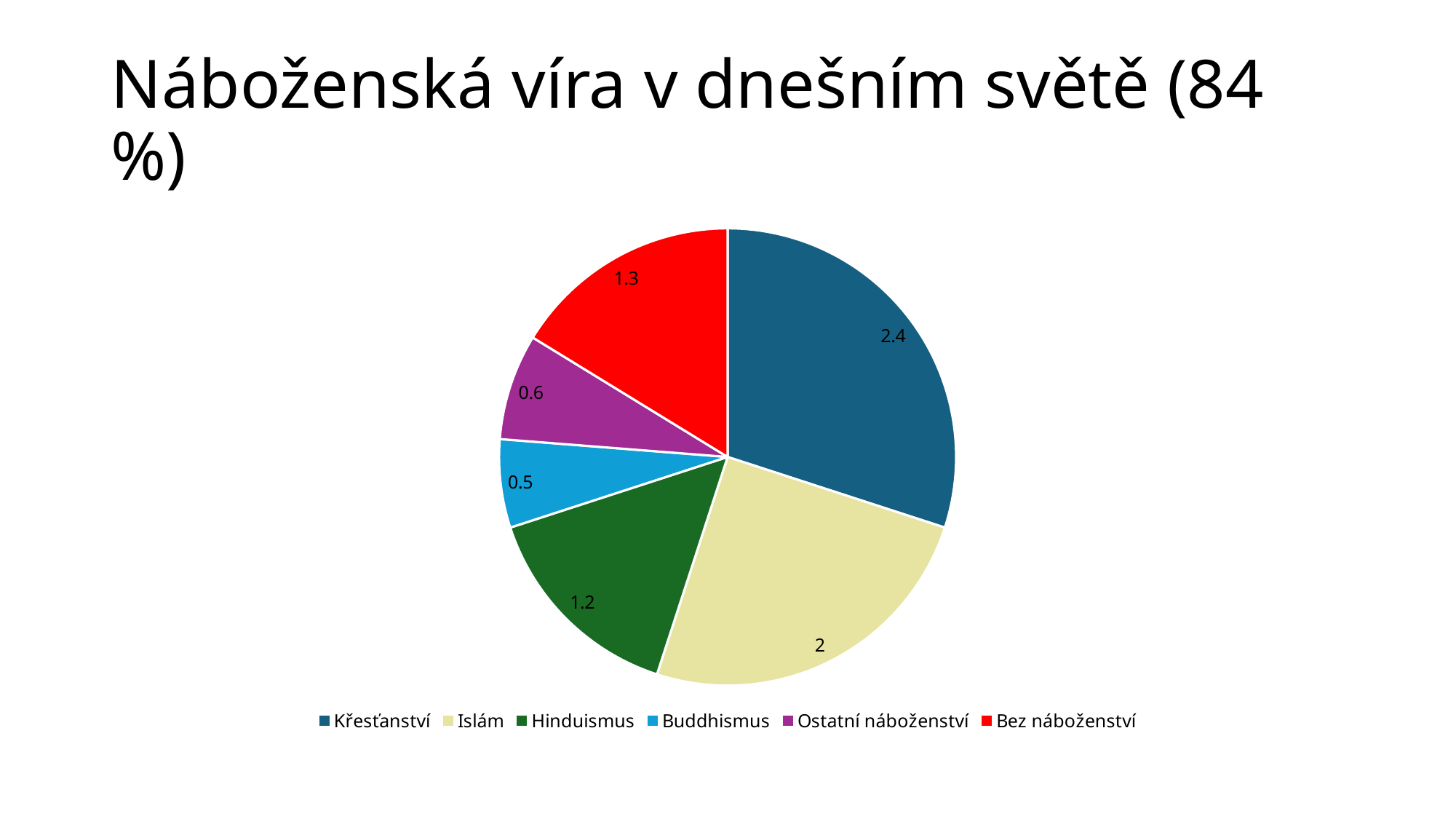
What is the value for Křesťanství? 2.4 What is the difference between the values for Křesťanství and Islám? 0.4 What is the value for Bez náboženství? 1.3 Which category has the largest slice? Křesťanství Which category has the smallest slice? Buddhismus What is the value for Hinduismus? 1.2 What is the value for Buddhismus? 0.5 How many slices does the pie chart have? 6 Which is larger, the value for Hinduismus or the value for Bez náboženství? Bez náboženství What colour is the slice for Ostatní náboženství? purple What share of the pie does Islám represent? 25% What type of chart is shown on the slide? pie chart